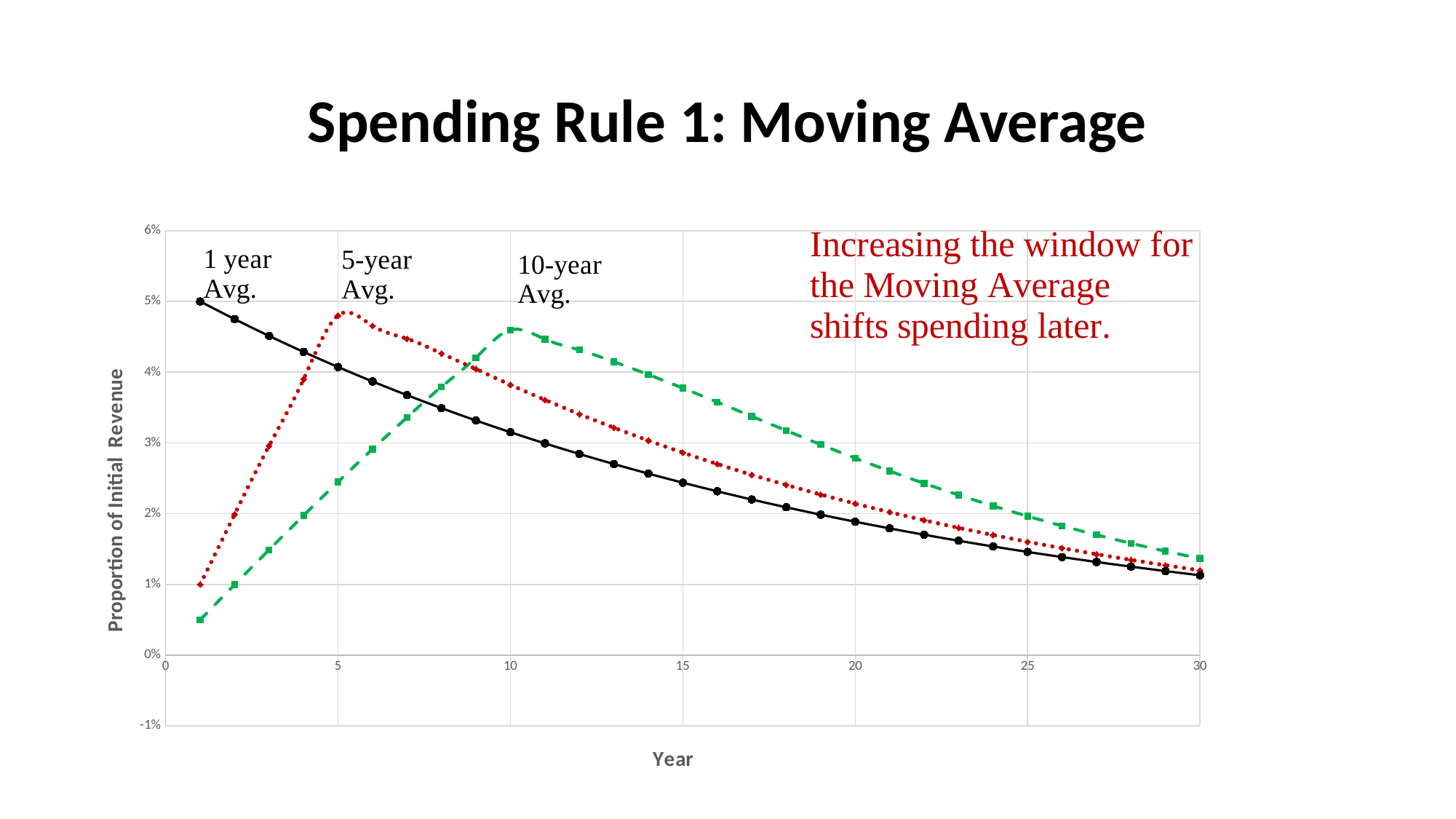
Is the value of the 10-year Avg. series at year 10 greater or less than 4%? greater Is the value of the 5-year Avg. series at year 5 greater or less than 4%? greater What is the value of the 1 year Avg. series at year 1? 5% What is the title of the vertical axis? Proportion of Initial Revenue At year 20, which series has the higher value: 10-year Avg. or 1 year Avg.? 10-year Avg. Is the value of the 1 year Avg. series at year 30 greater or less than 2%? less Which series has the lowest value at year 1? 10-year Avg. Does the 1 year Avg. series rise or fall as the year increases? fall What is the value of the 5-year Avg. series at year 1? 1% How many series are plotted on the chart? 3 Which series has the highest value at year 1? 1 year Avg. What kind of chart is shown on the slide? line chart